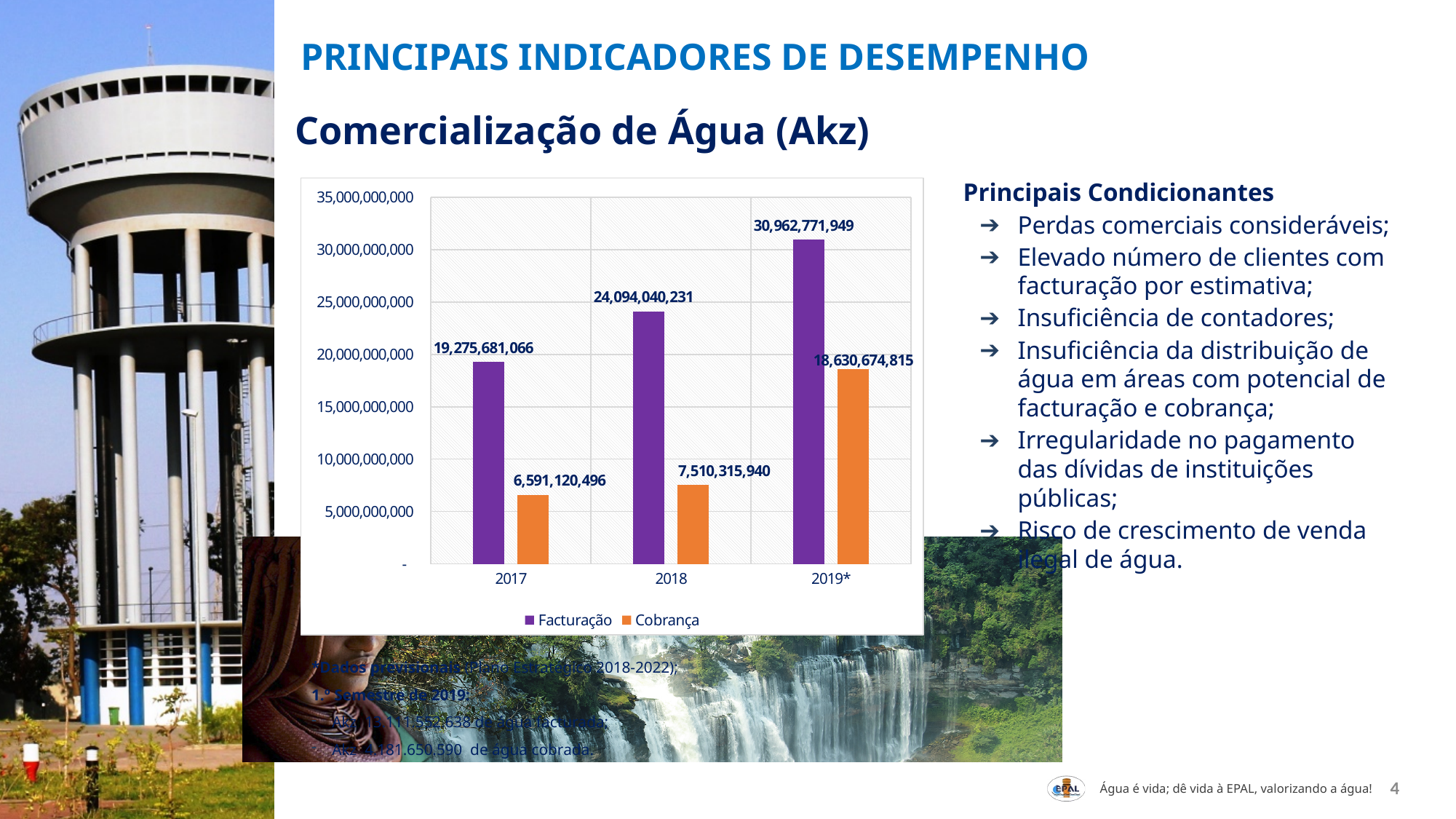
What is the difference between Facturação and Cobrança in 2019*? 12,332,097,134 How many series does the chart legend list? 2 In which year is Cobrança lowest? 2017 In which year is Facturação highest? 2019* What type of chart is shown on the slide? bar chart By how much did Facturação increase from 2017 to 2018? 4,818,359,165 What is the Facturação value for 2017? 19,275,681,066 What is the Cobrança value for 2018? 7,510,315,940 What is the Cobrança value for 2019*? 18,630,674,815 How many years (categories) are shown on the x axis of the chart? 3 Does Facturação rise or fall from 2017 to 2019*? rise What is the Facturação value for 2019*? 30,962,771,949